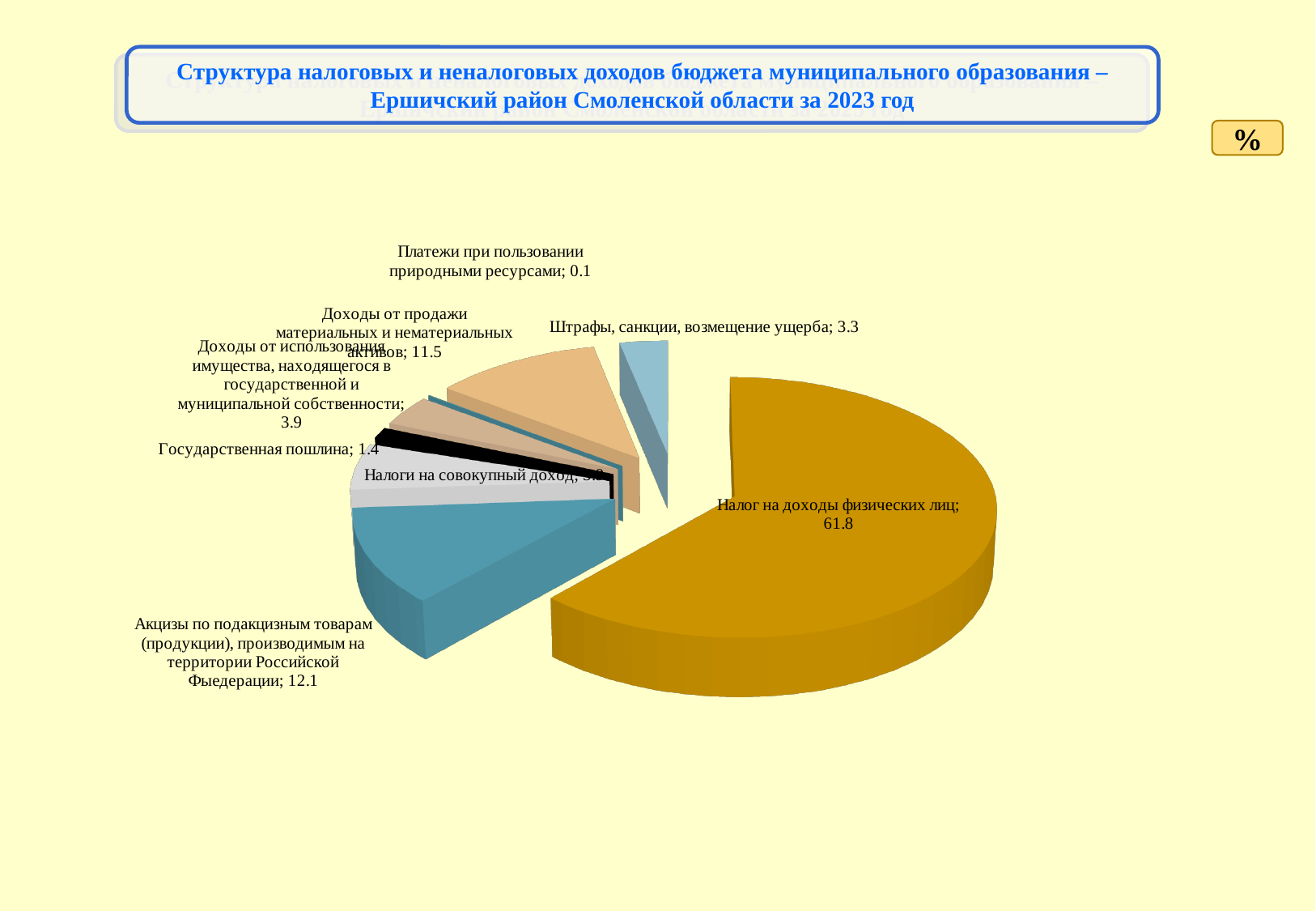
What is the value for Акцизы по подакцизным товарам (продукции), производимым на территории Российской Фыедерации? 12.1 Which category has the largest share of the pie? Налог на доходы физических лиц Which category has the smallest share of the pie? Платежи при пользовании природными ресурсами How many categories (slices) does the pie chart have? 8 What is the value for Платежи при пользовании природными ресурсами? 0.1 What is the value for Налог на доходы физических лиц? 61.8 Which is larger: Доходы от использования имущества, находящегося в государственной и муниципальной собственности, or Штрафы, санкции, возмещение ущерба? Доходы от использования имущества, находящегося в государственной и муниципальной собственности What is the difference between the values for Налог на доходы физических лиц and Акцизы по подакцизным товарам? 49.7 What is the value for Доходы от продажи материальных и нематериальных активов? 11.5 What is the value for Штрафы, санкции, возмещение ущерба? 3.3 What kind of chart is shown on the slide? pie chart What is the value for Государственная пошлина? 1.4